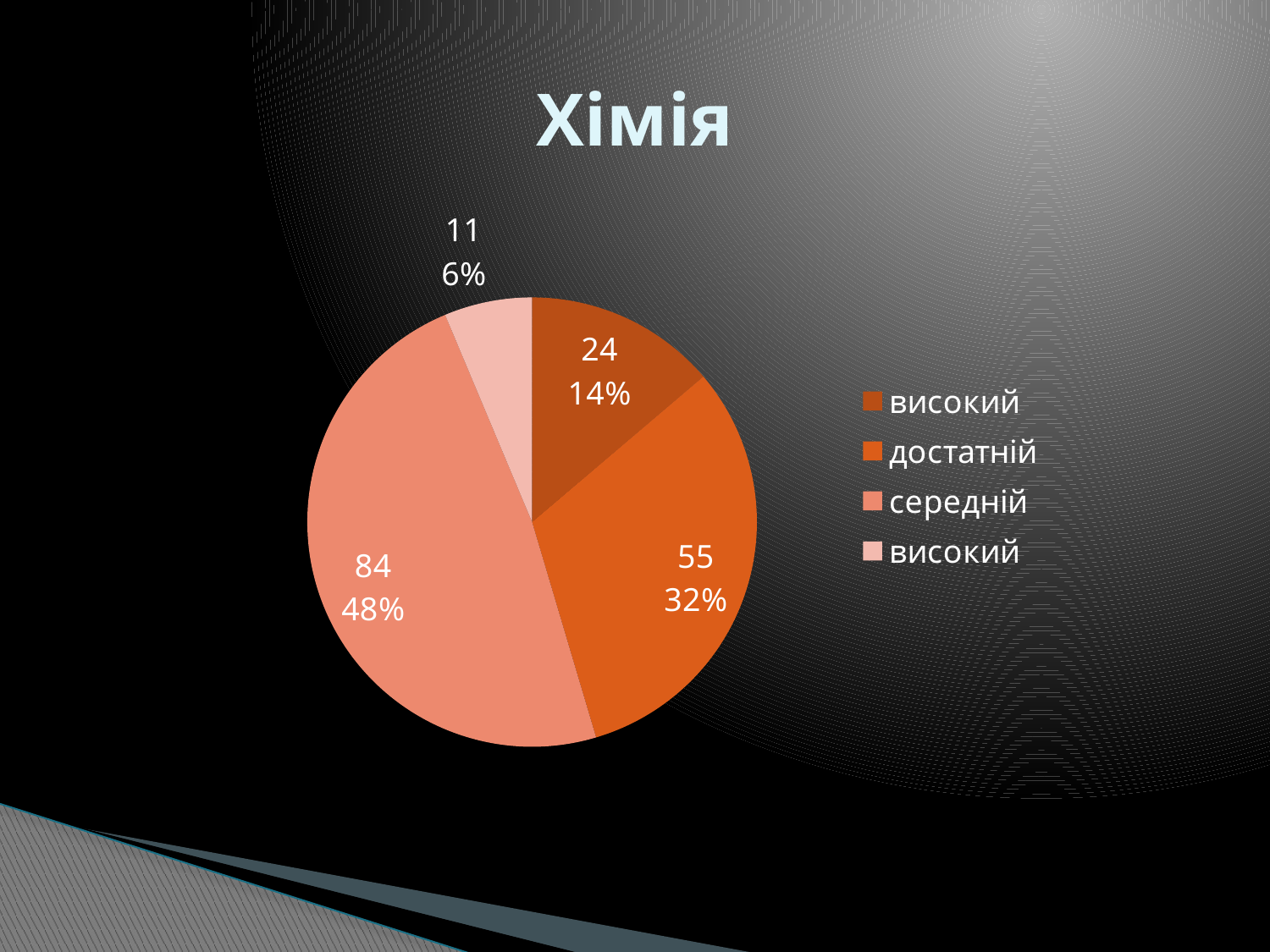
What percentage share does the достатній slice have? 32% What value is shown for the середній slice? 84 How many entries does the legend list? 4 What percentage share does the середній slice have? 48% What is the difference between the середній value and the достатній value? 29 Which is larger, the достатній slice or the середній slice? середній Which legend category has the largest slice? середній How many slices does the pie chart have? 4 What is the percentage share of the smallest slice? 6% What is the title of the chart? Хімія What value is shown for the достатній slice? 55 What kind of chart is shown on the slide? pie chart